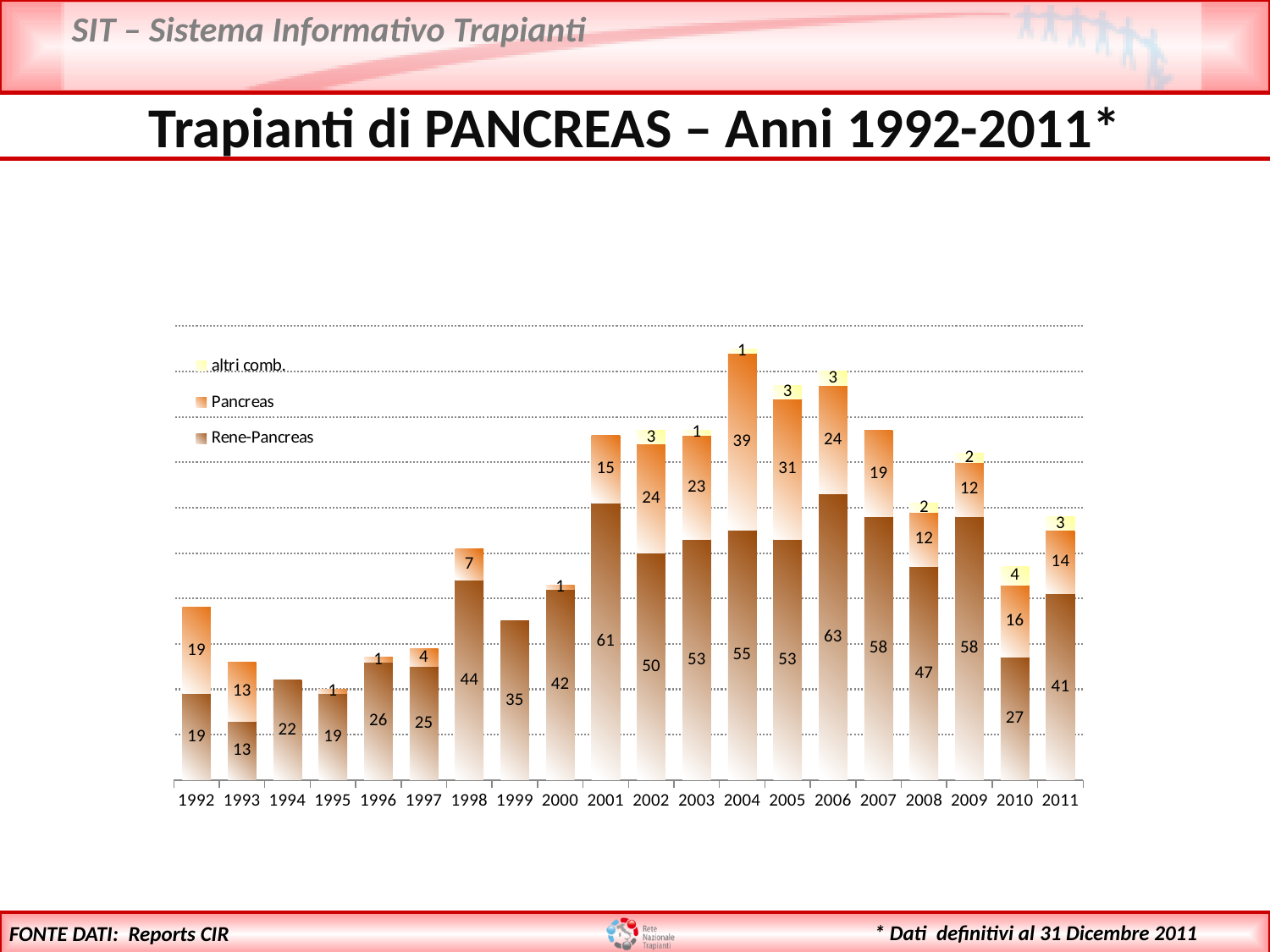
Which year has the lowest Rene-Pancreas value? 1993 What is the total of the stacked bar for 2011? 58 What is the Rene-Pancreas value for 2006? 63 What is the Pancreas value for 2004? 39 Which year has the highest Rene-Pancreas value? 2006 What is the altri comb. value for 2010? 4 How many years are shown on the x axis? 20 What is the total of the stacked bar for 2004? 95 What is the difference between the Rene-Pancreas values for 2009 and 2010? 31 What kind of chart is shown on the slide? Stacked bar chart Which is larger, the Pancreas value for 2005 or the Pancreas value for 2006? 2005 How many series does the legend list? 3